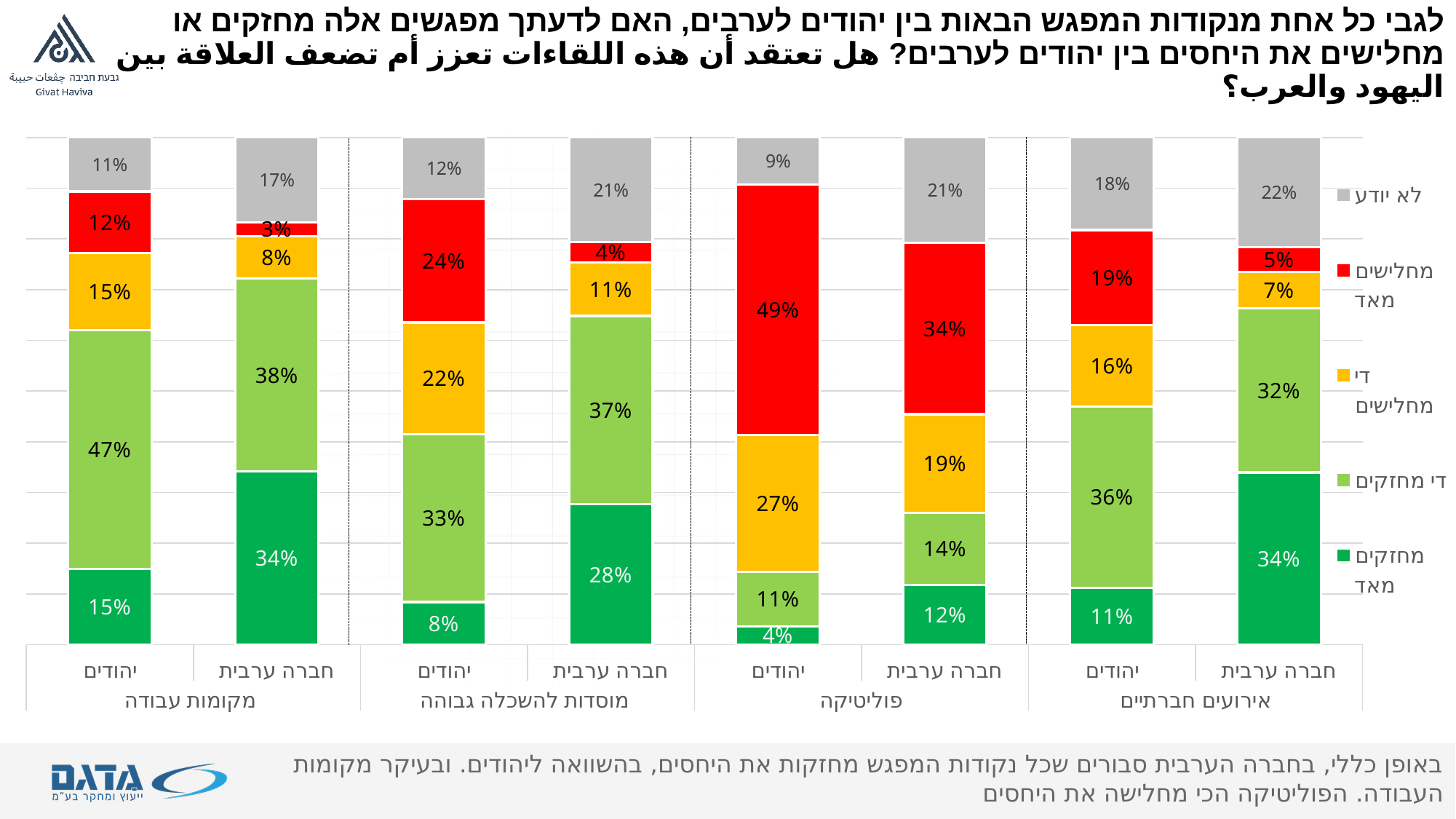
What percentage of חברה ערבית in the מקומות עבודה group answered מחזקים מאד? 34% Across all eight bars, which bar has the lowest מחזקים מאד value? יהודים, פוליטיקה What percentage of יהודים in the פוליטיקה group answered מחלישים מאד? 49% What percentage of יהודים in the מוסדות להשכלה גבוהה group answered די מחלישים? 22% Which has a larger מחזקים מאד value: יהודים or חברה ערבית in the אירועים חברתיים group? חברה ערבית How many series does the legend list? 5 What percentage of חברה ערבית in the אירועים חברתיים group answered לא יודע? 22% What is the difference between the די מחזקים values for יהודים and חברה ערבית in the מקומות עבודה group? 9% What kind of chart is shown on the slide? Stacked bar chart How many bars are plotted in the chart? 8 Across all eight bars, which bar has the highest מחלישים מאד value? יהודים, פוליטיקה Which colour represents the מחלישים מאד series in the legend? Red